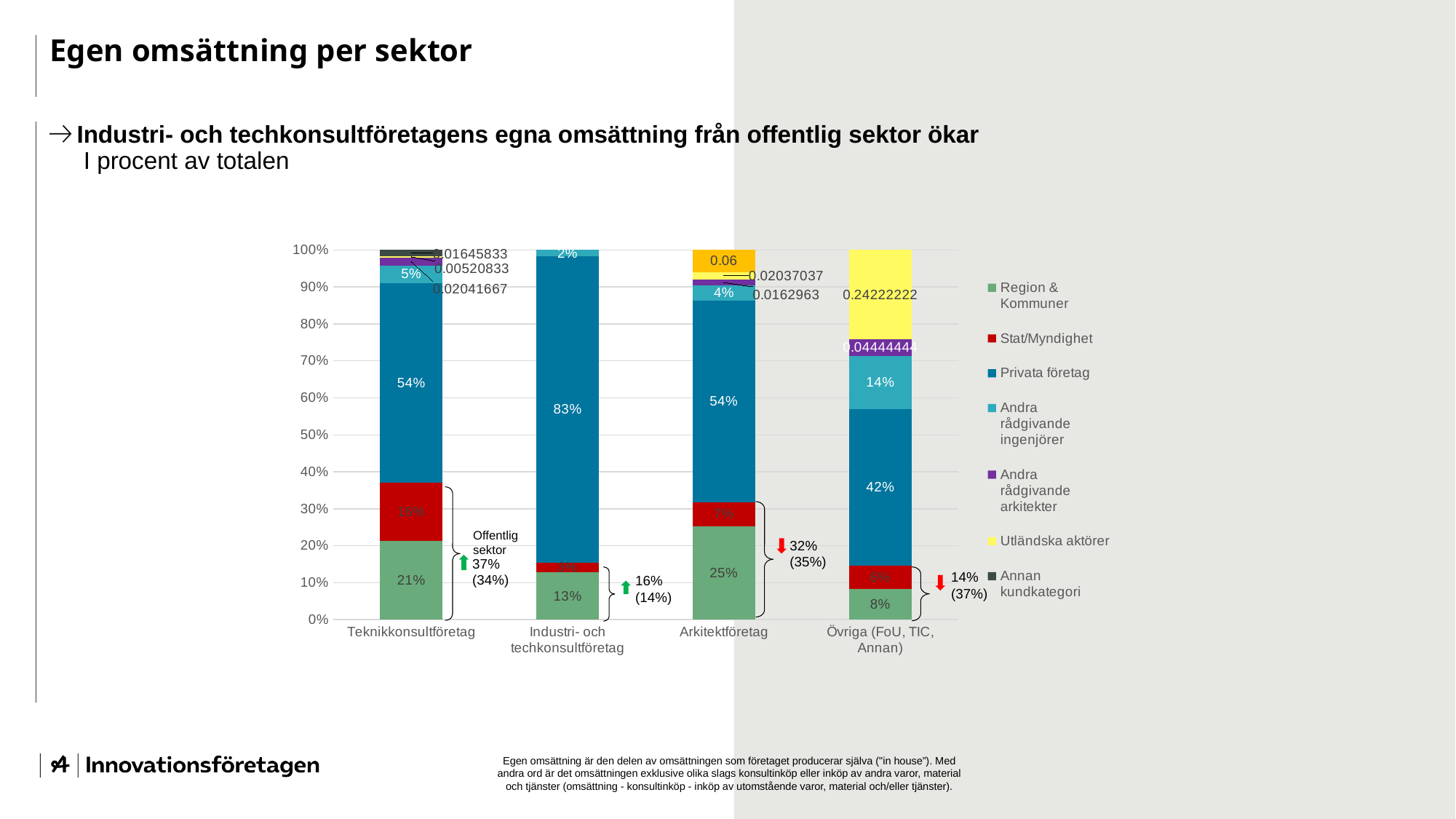
Which has a larger Region & Kommuner share, Teknikkonsultföretag or Industri- och techkonsultföretag? Teknikkonsultföretag What is the difference in Privata företag share between Teknikkonsultföretag and Övriga (FoU, TIC, Annan)? 12 percentage points Which category has the lowest Region & Kommuner share? Övriga (FoU, TIC, Annan) What is the Privata företag share for Industri- och techkonsultföretag? 83% How many company categories are shown along the x axis of the chart? 4 What colour represents Utländska aktörer in the chart's legend? Yellow What is the Region & Kommuner share for Arkitektföretag? 25% How many series does the chart's legend list? 7 What kind of chart is shown on the slide? Stacked bar chart What is the Andra rådgivande ingenjörer share for Övriga (FoU, TIC, Annan)? 14% Which category has the highest Privata företag share? Industri- och techkonsultföretag What is the Utländska aktörer value shown for Övriga (FoU, TIC, Annan)? 0.24222222